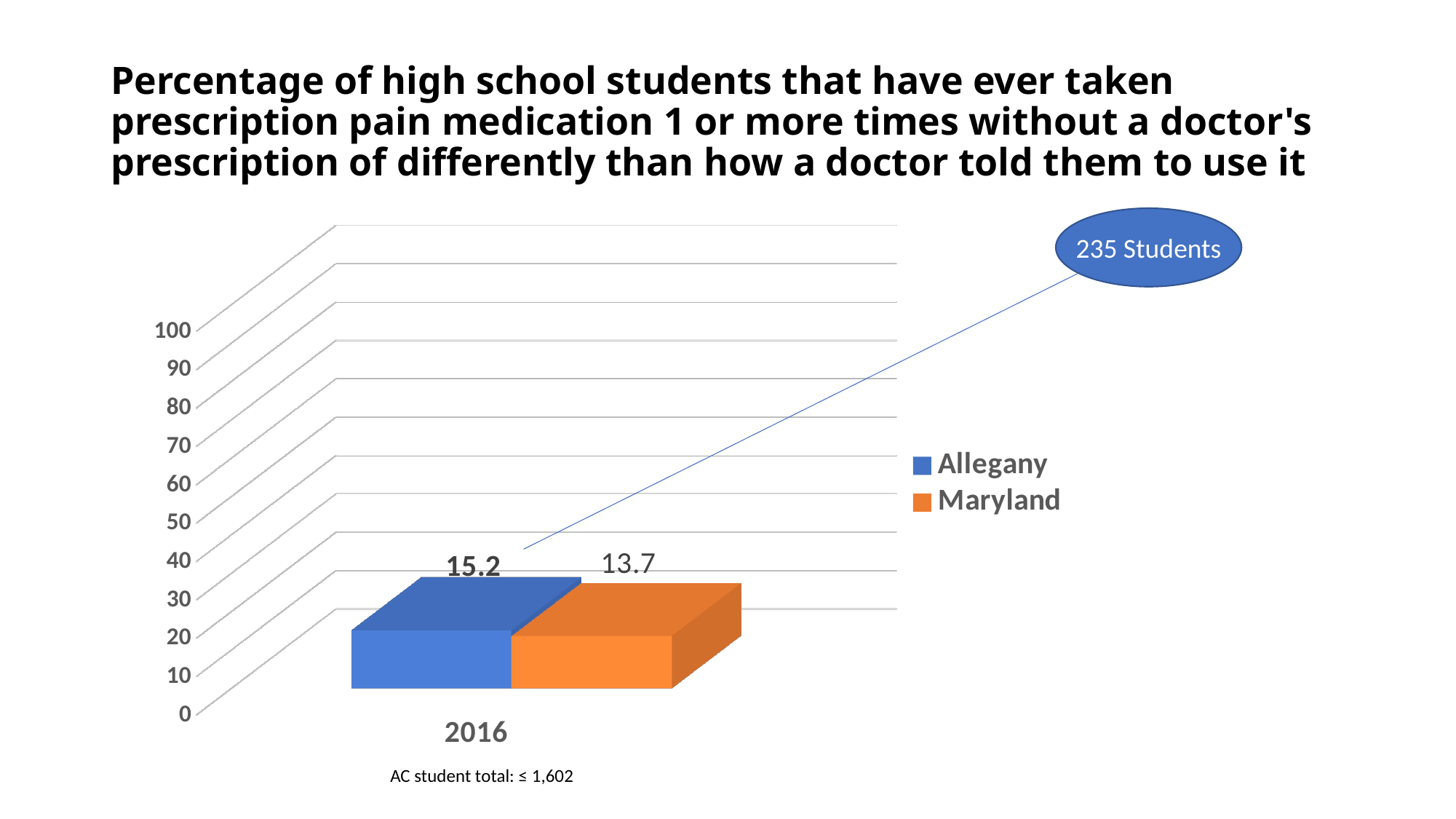
How many series does the legend list? 2 What colour represents Maryland in the legend? orange What is the difference between the Allegany and Maryland values in 2016? 1.5 How many categories are shown on the x axis? 1 Which series has the higher value in 2016, Allegany or Maryland? Allegany Is the value for Allegany in 2016 greater or less than 20? less What is the highest value shown on the vertical axis? 100 What is the value for Maryland in 2016? 13.7 What is the value for Allegany in 2016? 15.2 Which year is shown on the x axis? 2016 Is the value for Maryland in 2016 greater or less than 10? greater What kind of chart is shown on the slide? bar chart